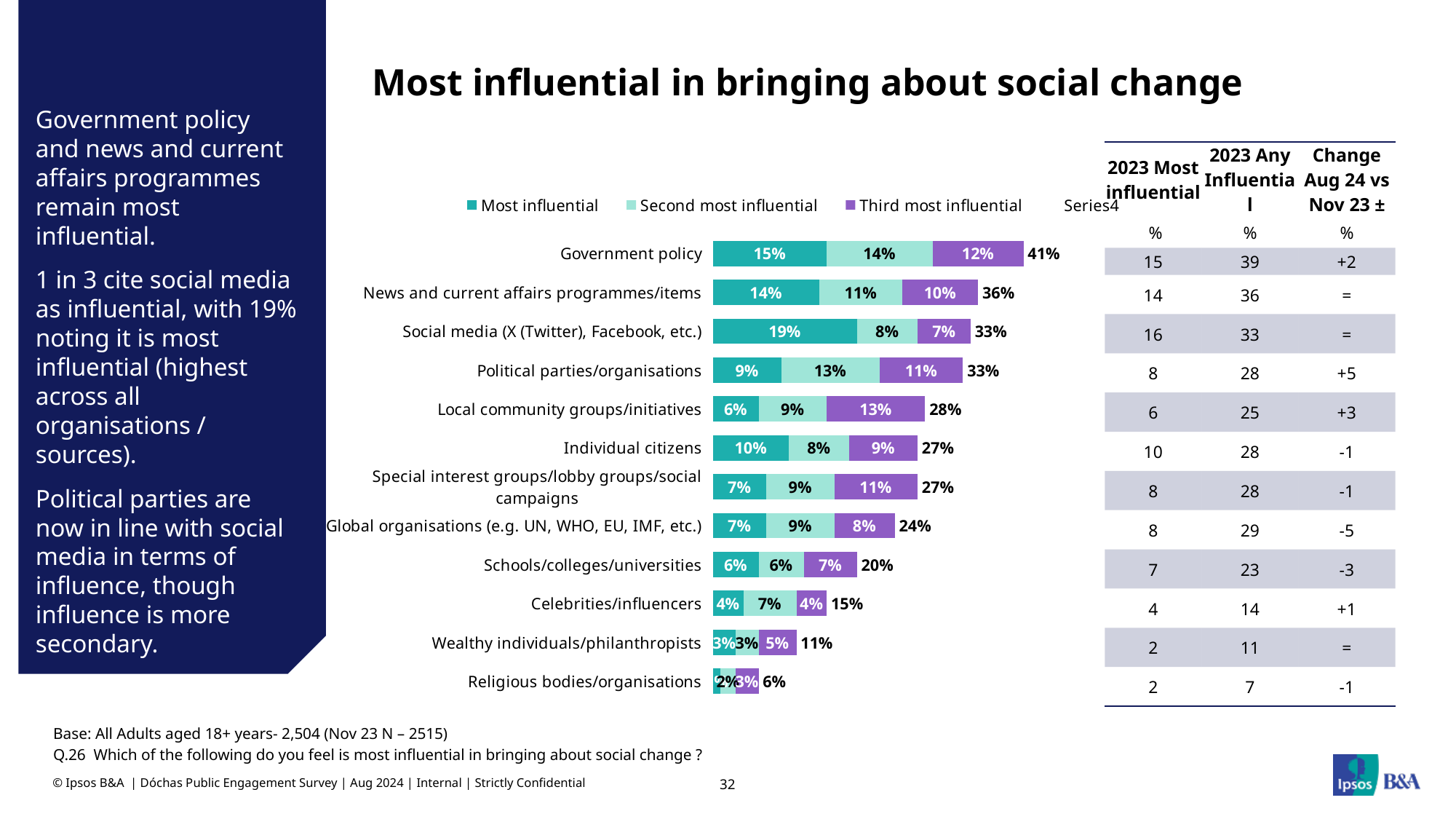
What is the difference between the total for Government policy and the total for News and current affairs programmes/items? 5% What is the title of the chart? Most influential in bringing about social change Which category has the highest 'Most influential' value? Social media (X (Twitter), Facebook, etc.) What kind of chart is shown on the slide? bar chart How many categories are plotted in the chart? 12 Which category has the lowest total value? Religious bodies/organisations What is the 'Most influential' value for Social media (X (Twitter), Facebook, etc.)? 19% Which has the larger total, Political parties/organisations or Individual citizens? Political parties/organisations What is the 'Second most influential' value for Political parties/organisations? 13% What is the 'Third most influential' value for Local community groups/initiatives? 13% What is the total value shown at the end of the Government policy bar? 41% What is the total of the stacked bar for Schools/colleges/universities? 20%